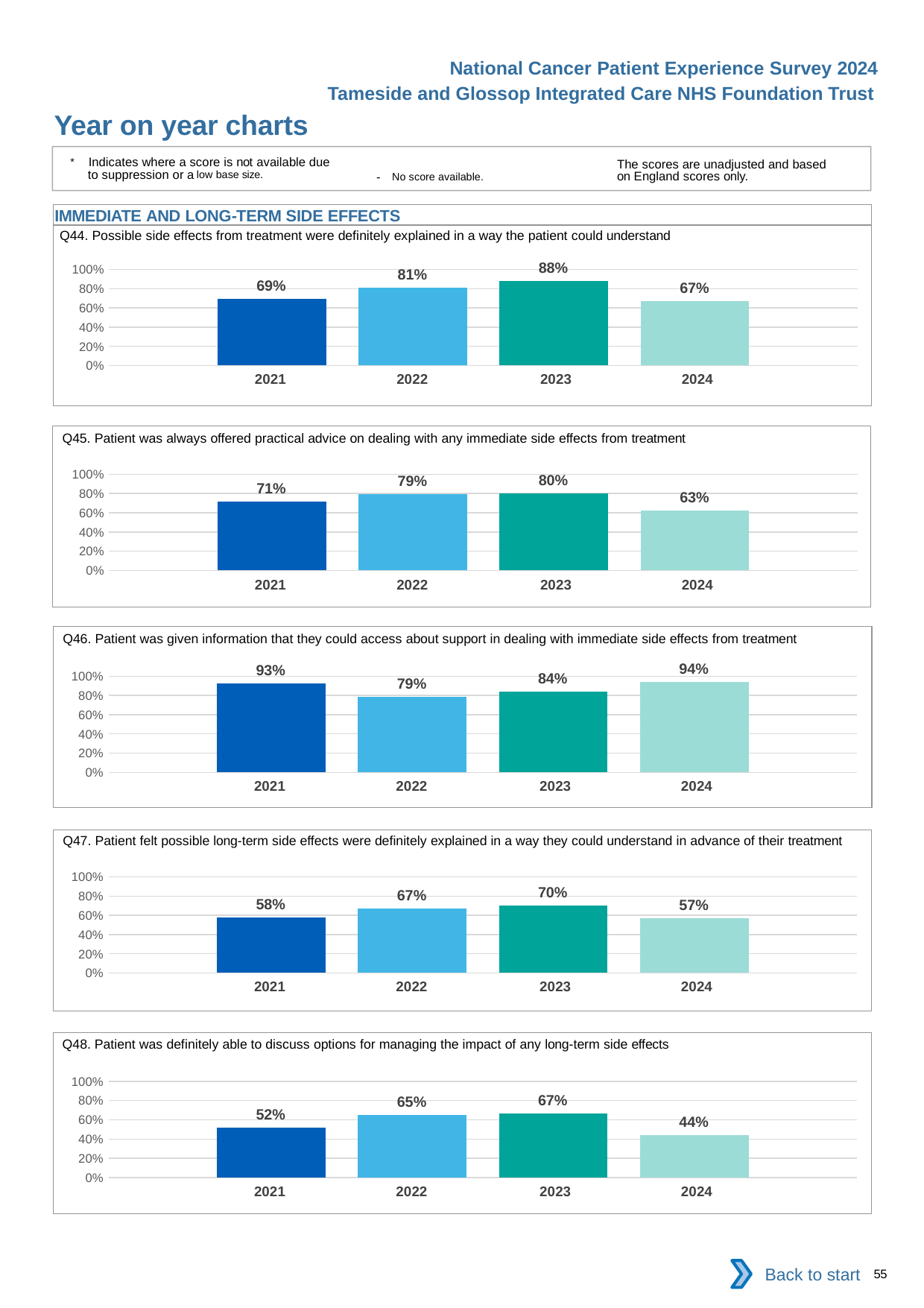
In the Q48 chart, what is the value for 2024? 44% In the Q46 chart, what is the difference between the 2024 and 2022 values? 15% In the Q45 chart, which year has the lowest value? 2024 How many bars are shown in the Q44 chart? 4 In the Q47 chart, is the value for 2024 greater or less than 60%? less In the Q44 chart, what is the value for 2023? 88% In the Q48 chart, which year has the highest value? 2023 How many charts are shown on the slide? 5 In the Q44 chart, what is the difference between the 2023 and 2024 values? 21% What kind of chart is the Q45 chart? bar chart In the Q46 chart, what is the value for 2021? 93% In the Q47 chart, which is larger, the value for 2021 or the value for 2022? 2022